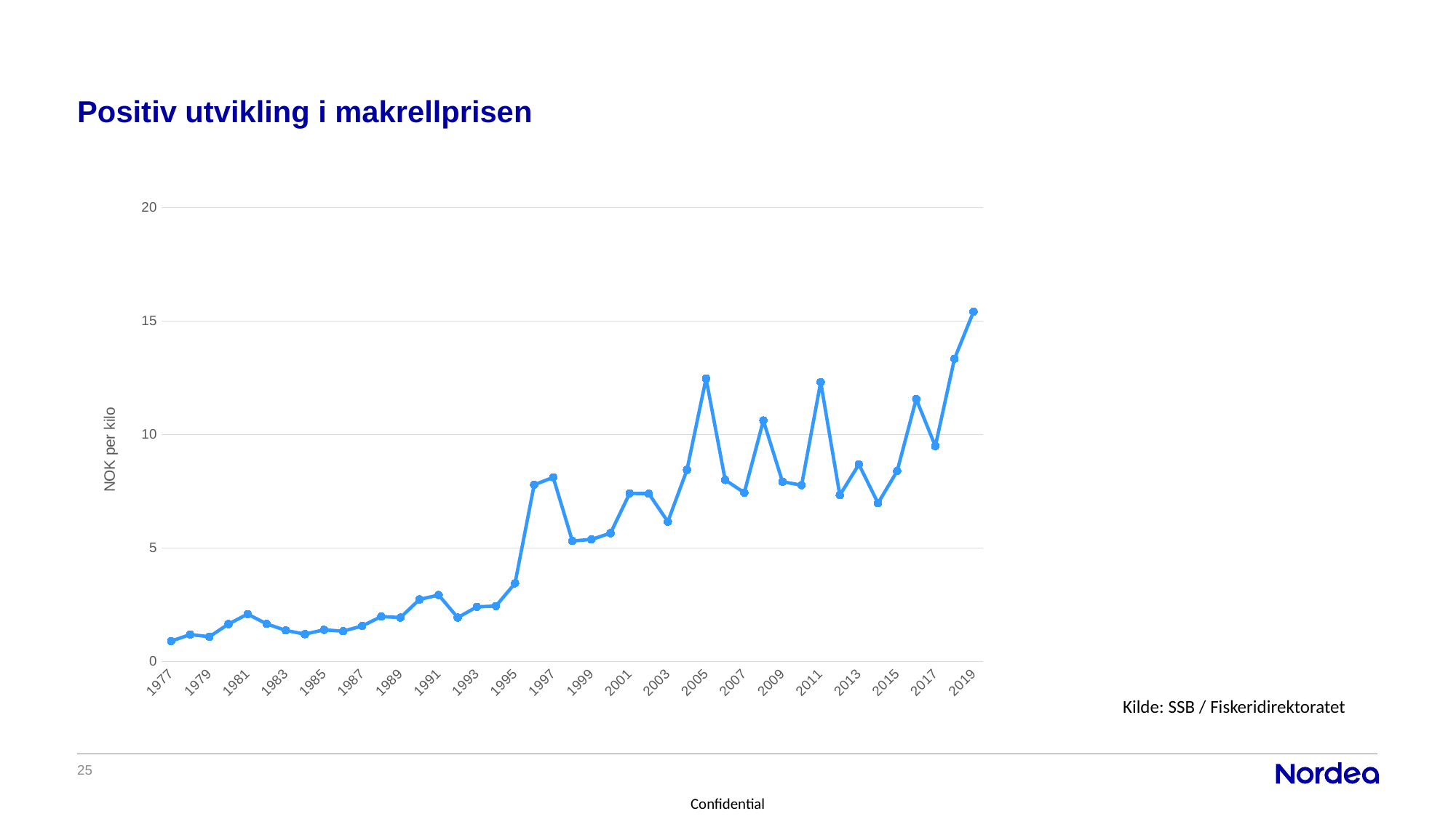
Which year has the larger value, 1995 or 1997? 1997 Is the value for 2019 greater or less than 15? greater Is the value for 2005 greater or less than 10? greater Is the value for 1977 greater or less than 5? less Overall, do the values rise or fall from 1977 to 2019? Rise How many year labels are shown on the x axis? 22 What kind of chart is shown on the slide? Line chart Which year has the highest value in the chart? 2019 Which year has the larger value, 2005 or 2007? 2005 What is the label on the vertical axis of the chart? NOK per kilo What is the title of the slide containing the chart? Positiv utvikling i makrellprisen